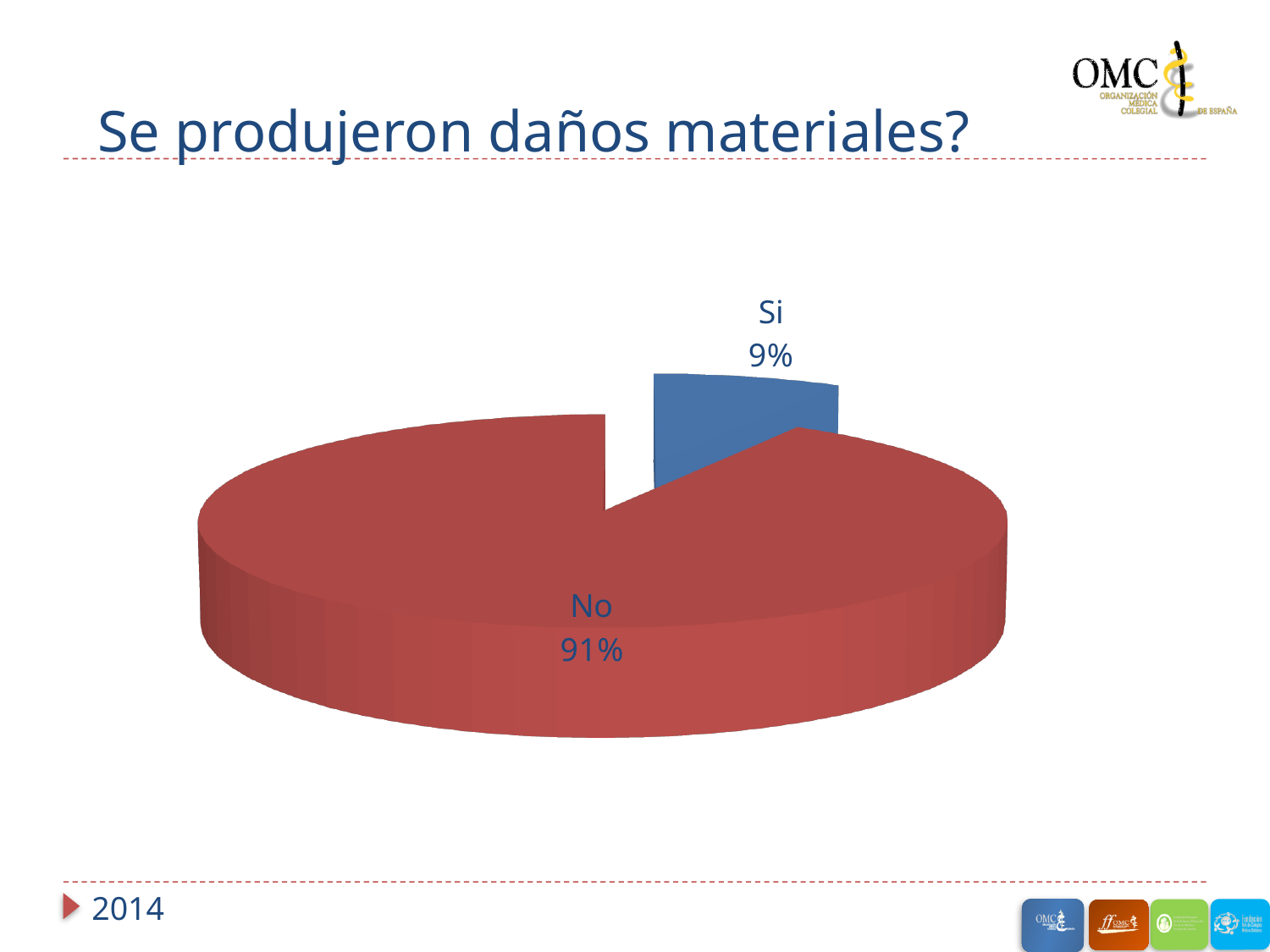
Which slice is the smallest in the pie chart? Si Which slice is the largest in the pie chart? No How many slices does the pie chart have? 2 Which is larger, the "Si" slice or the "No" slice? No What share of the pie does the "Si" slice represent? 9% What is the title of the slide containing the chart? Se produjeron daños materiales? What is the difference in percentage points between the "No" and "Si" slices? 82 What kind of chart is shown on the slide? Pie chart What share of the pie does the "No" slice represent? 91% What colour is the "Si" slice of the pie chart? Blue